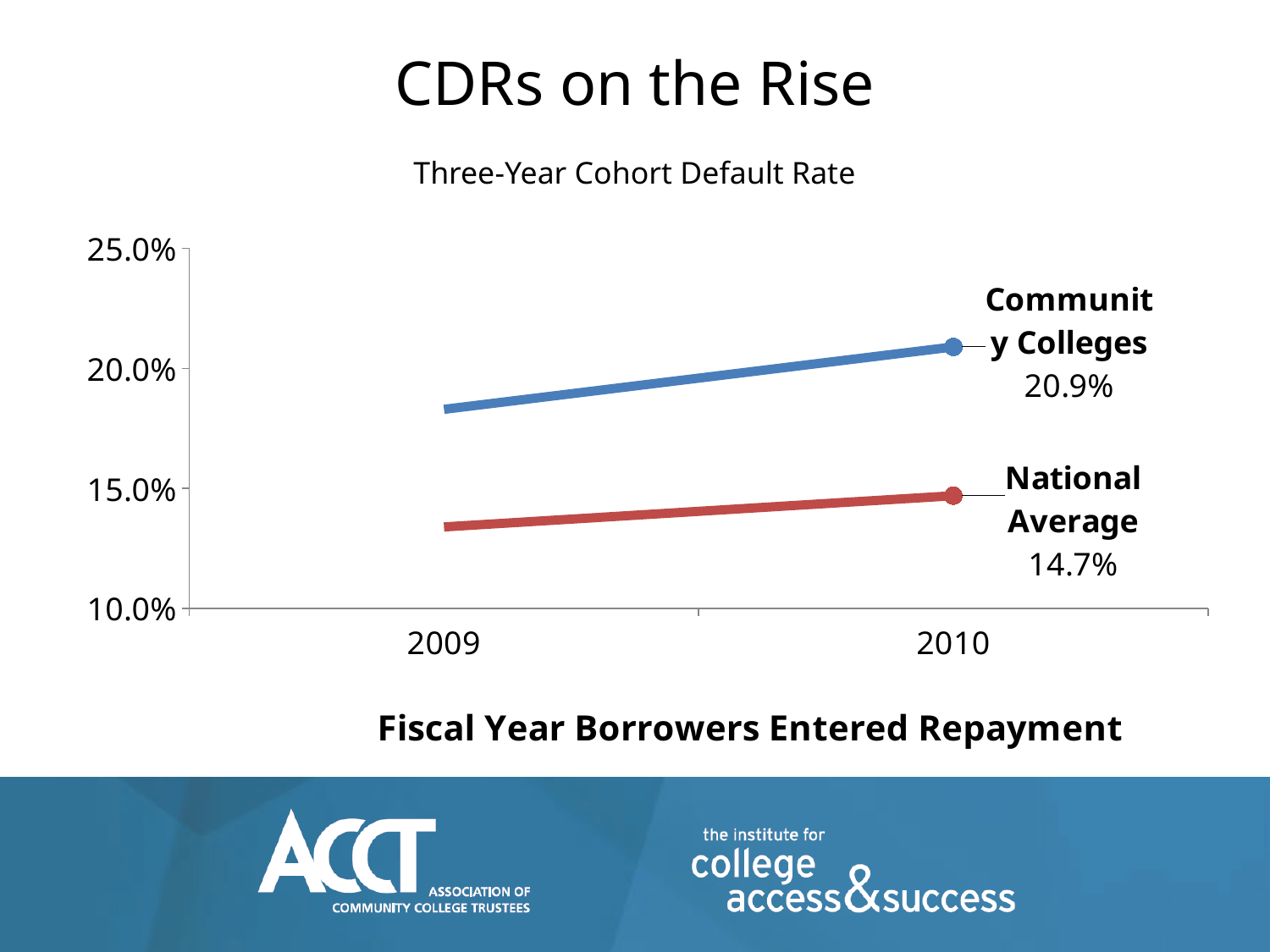
Do the default rates rise or fall from 2009 to 2010? rise By how many percentage points does the Community Colleges rate exceed the National Average in 2010? 6.2 percentage points What is the title of the x axis? Fiscal Year Borrowers Entered Repayment What is the National Average three-year cohort default rate in 2010? 14.7% How many fiscal years are shown on the x axis? 2 What kind of chart is shown on the slide? line chart How many data series (lines) are plotted on the chart? 2 What is the three-year cohort default rate for Community Colleges in 2010? 20.9% Is the Community Colleges value for 2009 greater or less than 20.0%? less Is the National Average value for 2009 greater or less than 15.0%? less Which series has the higher default rate in 2010, Community Colleges or National Average? Community Colleges Is the Community Colleges value for 2010 greater or less than 20.0%? greater